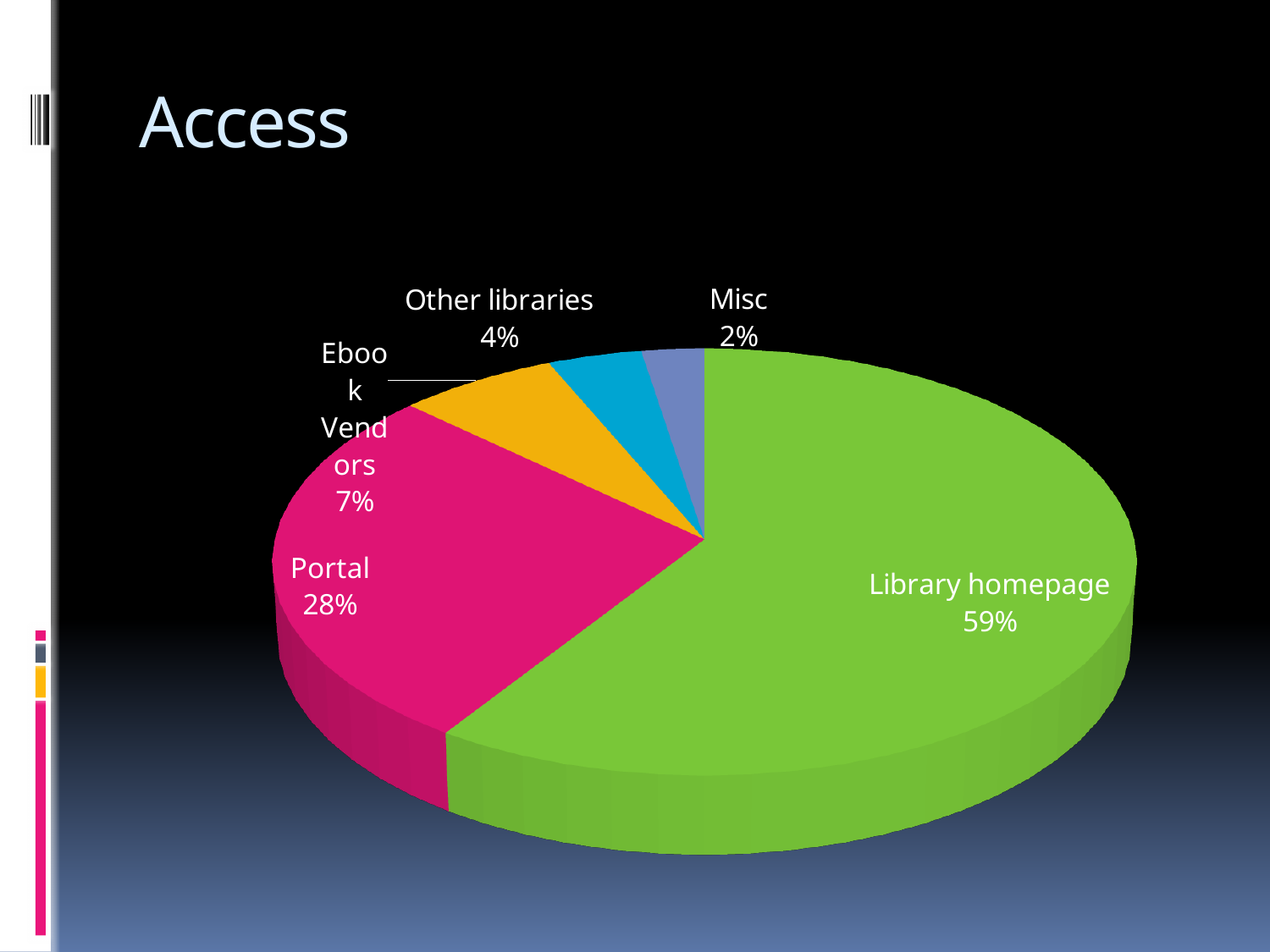
What kind of chart is shown on the slide? pie chart How many slices does the pie chart have? 5 What share of the pie does Library homepage have? 59% Which category has the smallest slice of the pie? Misc What share of the pie does Portal have? 28% Which category has the largest slice of the pie? Library homepage What is the title of the slide containing the pie chart? Access What share of the pie does Misc have? 2% Which is larger, Ebook Vendors or Other libraries? Ebook Vendors What is the difference in percentage points between Library homepage and Portal? 31